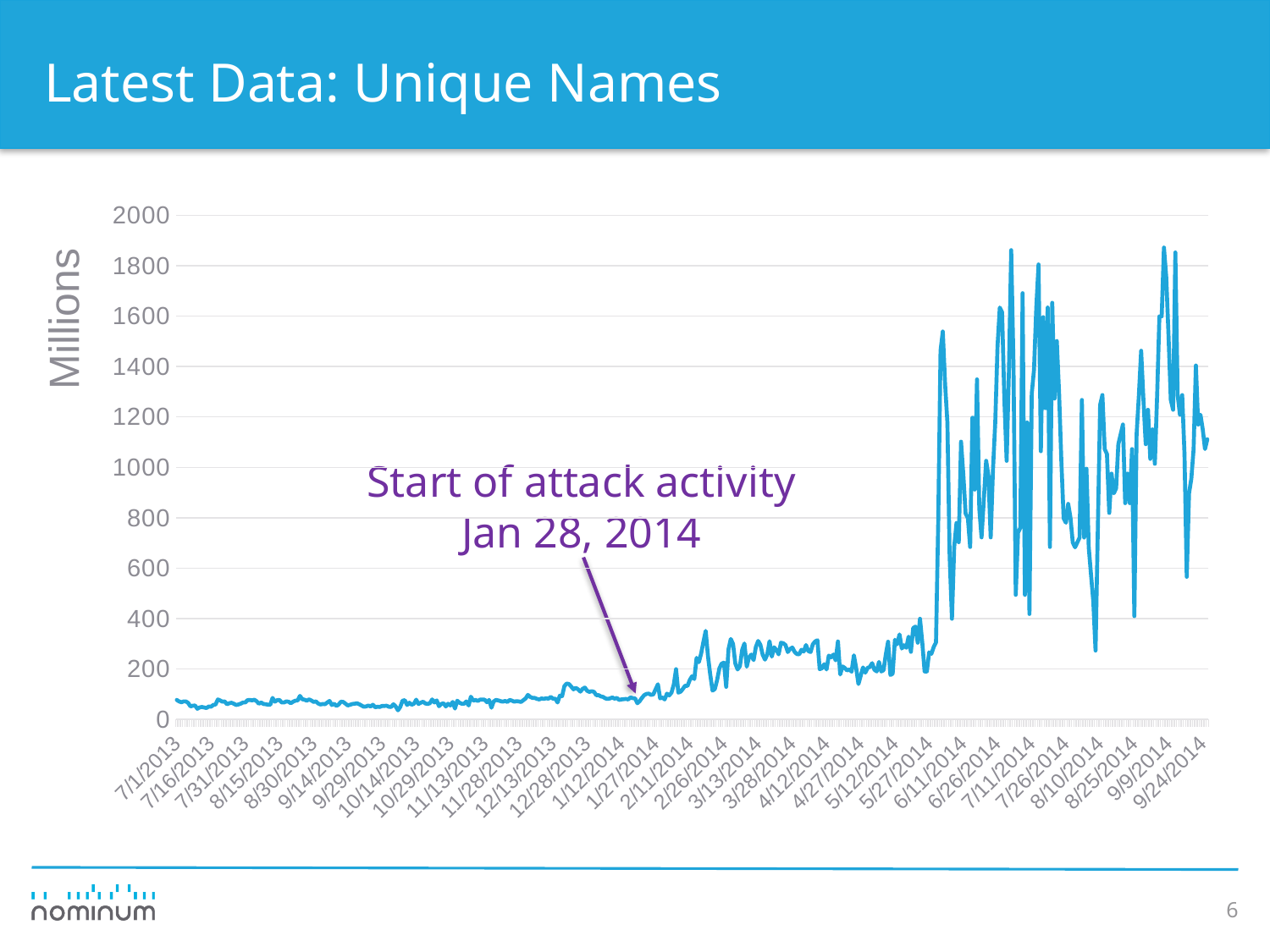
Is the value for 7/1/2013 greater or less than 200? less Which is larger, the value for 7/1/2013 or the value for 9/24/2014? 9/24/2014 According to the annotation on the chart, on what date did attack activity start? Jan 28, 2014 What kind of chart is shown on the slide? Line chart Is the value for 9/24/2014 greater or less than 800? greater Is the value for 1/27/2014 greater or less than 400? less Overall, do the values rise or fall from 7/1/2013 to 9/24/2014? rise What is the title of the chart on the slide? Latest Data: Unique Names What is the label on the vertical axis of the chart? Millions What is the highest tick value shown on the vertical axis? 2000 What is the first date label shown on the horizontal axis? 7/1/2013